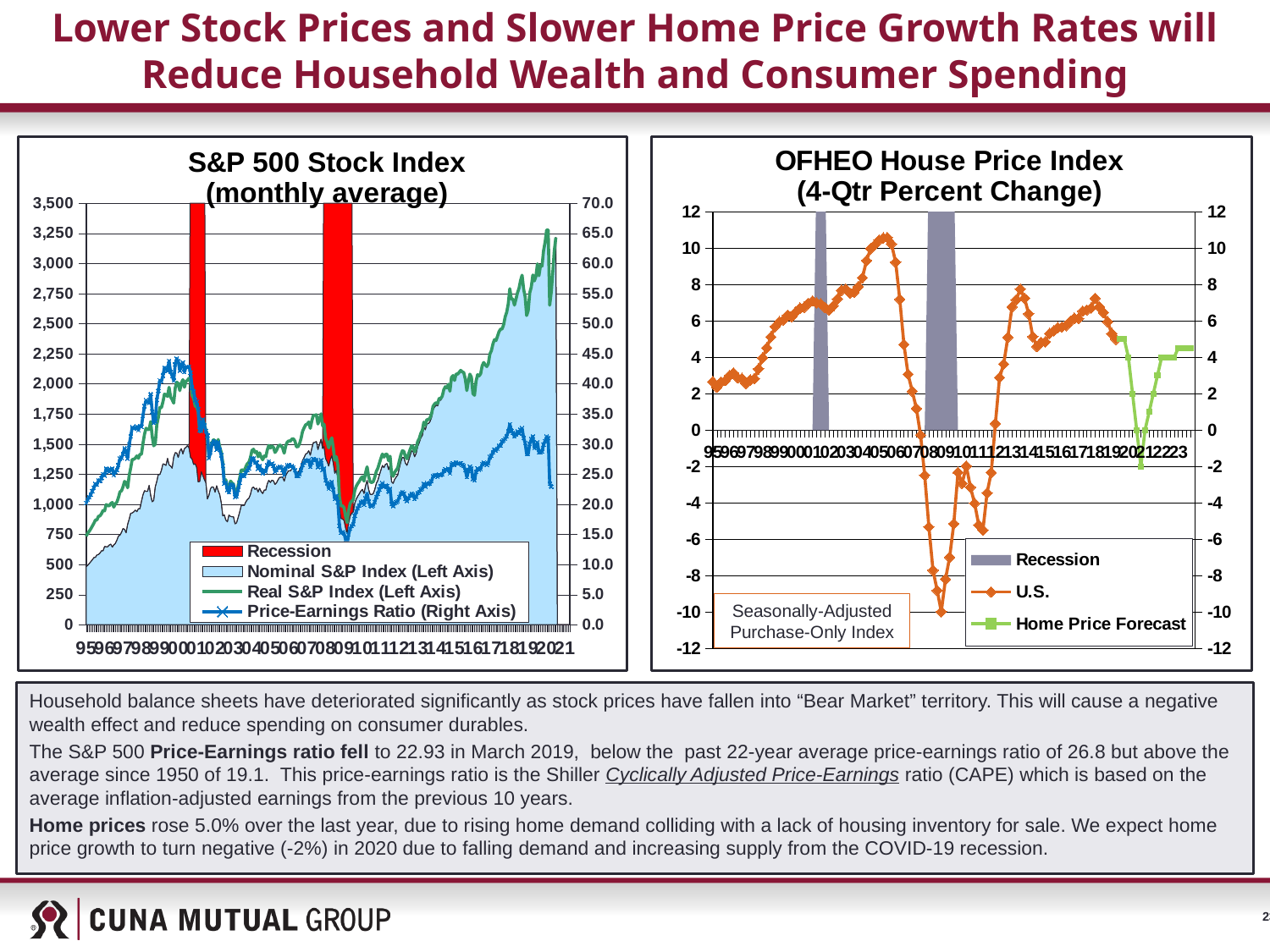
In the OFHEO House Price Index chart, is the lowest point of the Home Price Forecast series in 2020 greater or less than 0? less In the S&P 500 Stock Index chart, is the peak of the Price-Earnings Ratio around 2000 greater or less than 40.0? greater In the OFHEO House Price Index chart, is the lowest point of the U.S. series around 2009 greater or less than -8? less In the OFHEO House Price Index chart, how many recession periods are shaded? 2 What kind of chart is the S&P 500 Stock Index (monthly average) chart? combination area and line chart How many entries does the legend of the S&P 500 Stock Index (monthly average) chart list? 4 In the S&P 500 Stock Index chart, which series is plotted on the right axis according to the legend? Price-Earnings Ratio In the S&P 500 Stock Index chart, what is the highest value shown on the left axis? 3,500 How many entries does the legend of the OFHEO House Price Index (4-Qtr Percent Change) chart list? 3